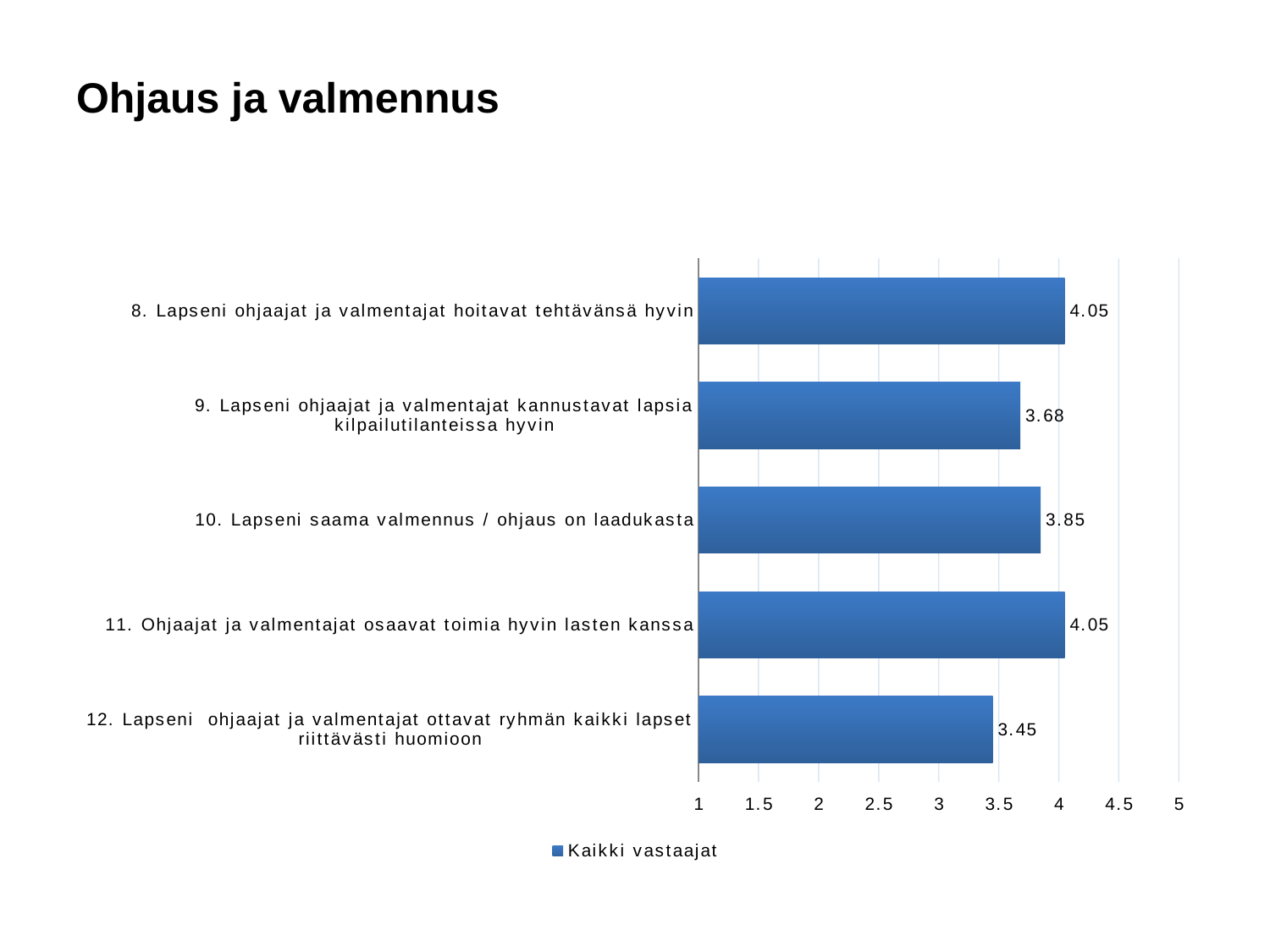
What is the difference between the values for item 10 and item 9? 0.17 What kind of chart is shown on the slide? Bar chart How many series does the legend list? 1 What is the value for "9. Lapseni ohjaajat ja valmentajat kannustavat lapsia kilpailutilanteissa hyvin"? 3.68 What is the difference between the values for item 8 and item 12? 0.6 What is the value for "10. Lapseni saama valmennus / ohjaus on laadukasta"? 3.85 What is the highest value shown in the chart? 4.05 What is the value for "12. Lapseni ohjaajat ja valmentajat ottavat ryhmän kaikki lapset riittävästi huomioon"? 3.45 Is the value for item 11 greater or less than 4? greater Which category has the lowest value? 12. Lapseni ohjaajat ja valmentajat ottavat ryhmän kaikki lapset riittävästi huomioon Which is larger, the value for item 10 or the value for item 9? Item 10 How many categories are shown in the chart? 5